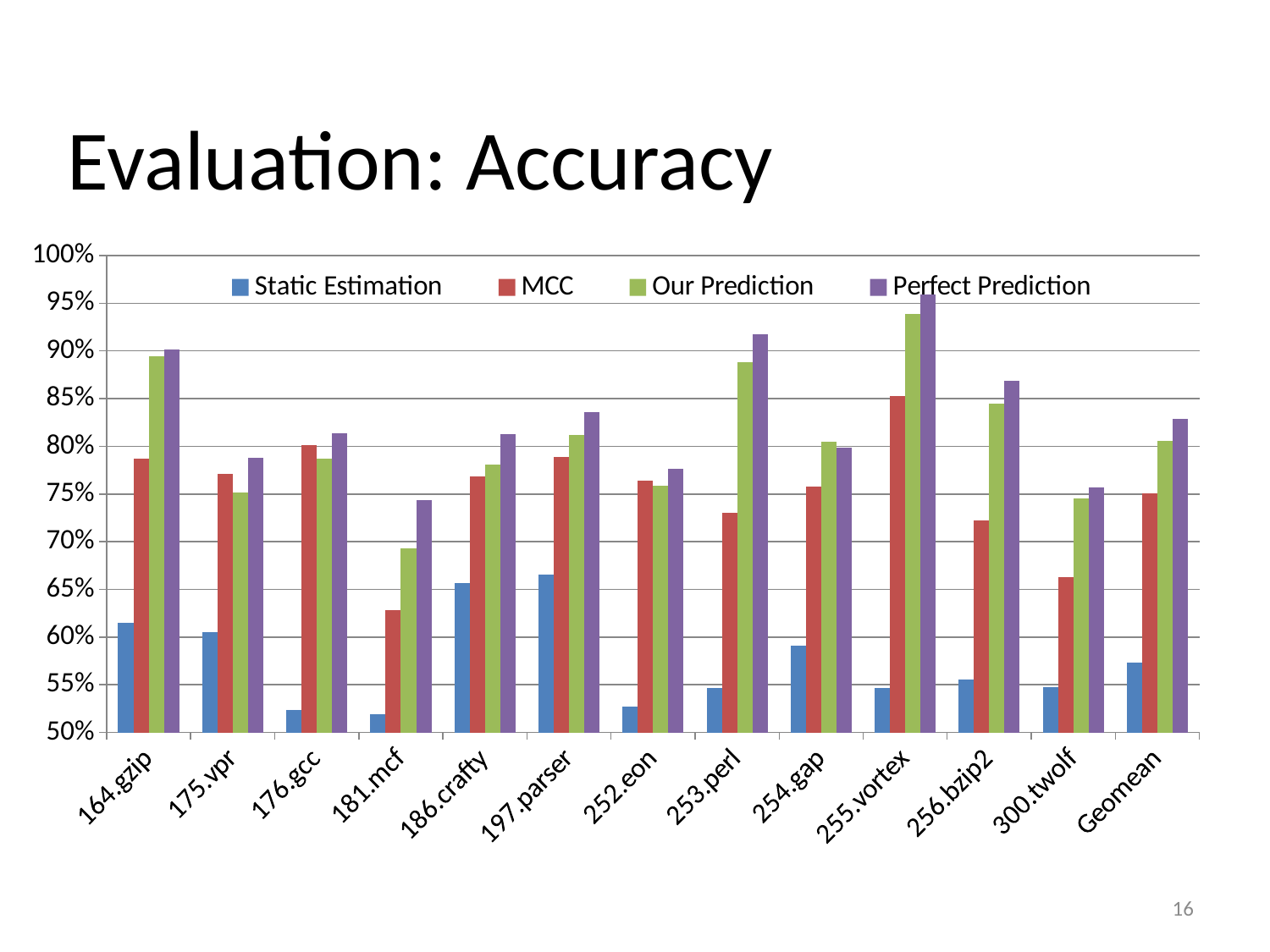
Is the Our Prediction value for 253.perl greater or less than 85%? greater What kind of chart is shown on the slide? bar chart What is the title of the slide containing the chart? Evaluation: Accuracy Which category has the highest Perfect Prediction value? 255.vortex Is the Static Estimation value for 164.gzip greater or less than 60%? greater For 253.perl, which is larger: the MCC value or the Our Prediction value? Our Prediction Which category has the lowest MCC value? 181.mcf Which category has the highest MCC value? 255.vortex Is the MCC value for 253.perl greater or less than 75%? less Which category has the highest Our Prediction value? 255.vortex How many categories are shown along the x axis? 13 How many series does the legend list? 4